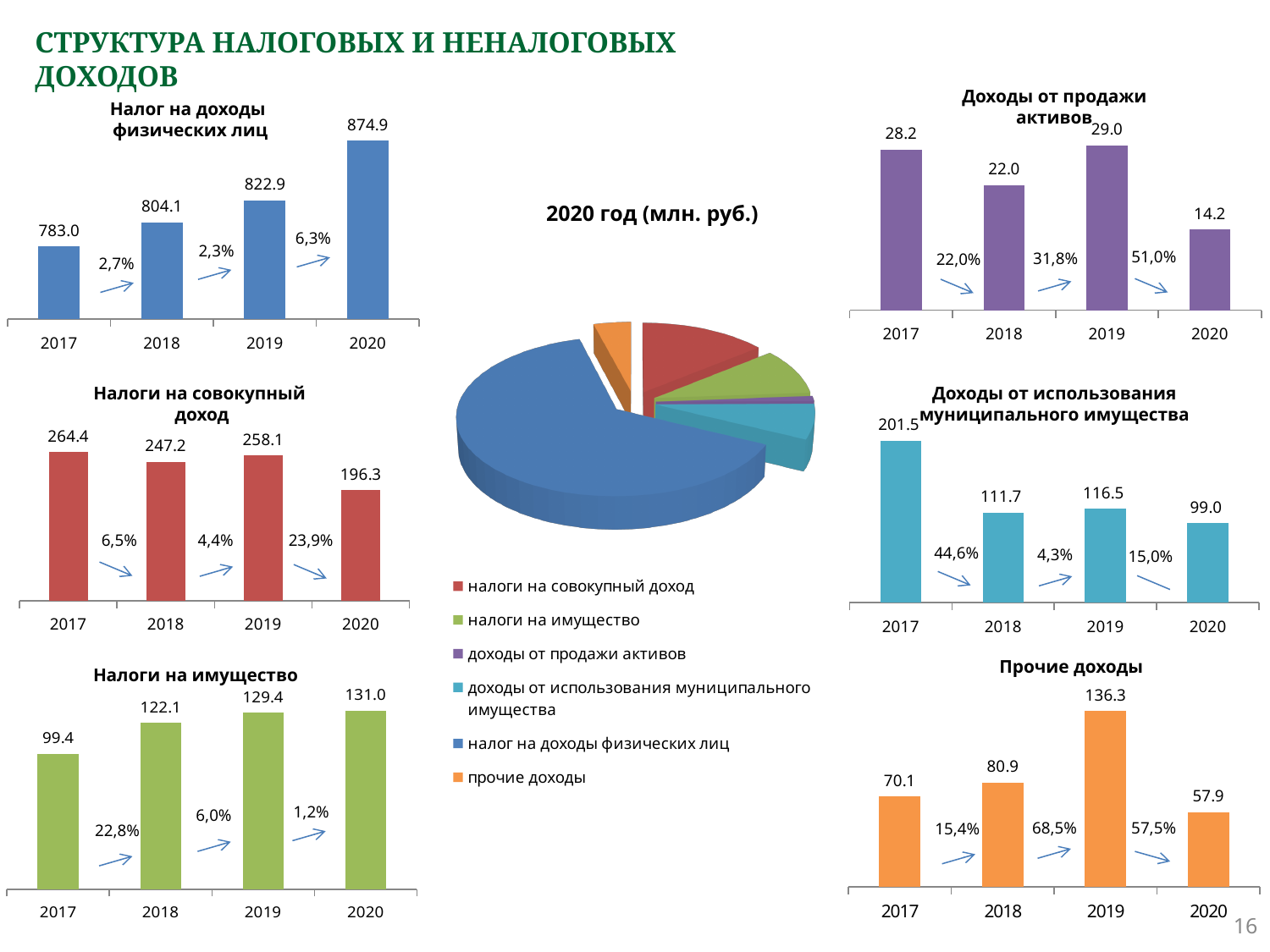
In the chart titled "Прочие доходы", which is larger: the value for 2018 or the value for 2020? 2018 In the chart titled "Налоги на совокупный доход", which year has the lowest value? 2020 In the chart titled "Прочие доходы", what is the difference between the values for 2019 and 2017? 66.2 How many years are shown on the x axis of the chart titled "Налоги на имущество"? 4 In the chart titled "Доходы от продажи активов", which year has the highest value? 2019 How many entries does the legend of the pie chart titled "2020 год (млн. руб.)" list? 6 What kind of chart is the chart titled "2020 год (млн. руб.)" in the centre of the slide? pie chart In the chart titled "Налоги на имущество", what is the difference between the values for 2020 and 2017? 31.6 In the chart titled "Налог на доходы физических лиц", do the values rise or fall from 2017 to 2020? rise In the chart titled "Доходы от использования муниципального имущества", what is the value for 2018? 111.7 In the chart titled "Налог на доходы физических лиц", what is the value for 2020? 874.9 What kind of chart is the chart titled "Доходы от продажи активов"? bar chart